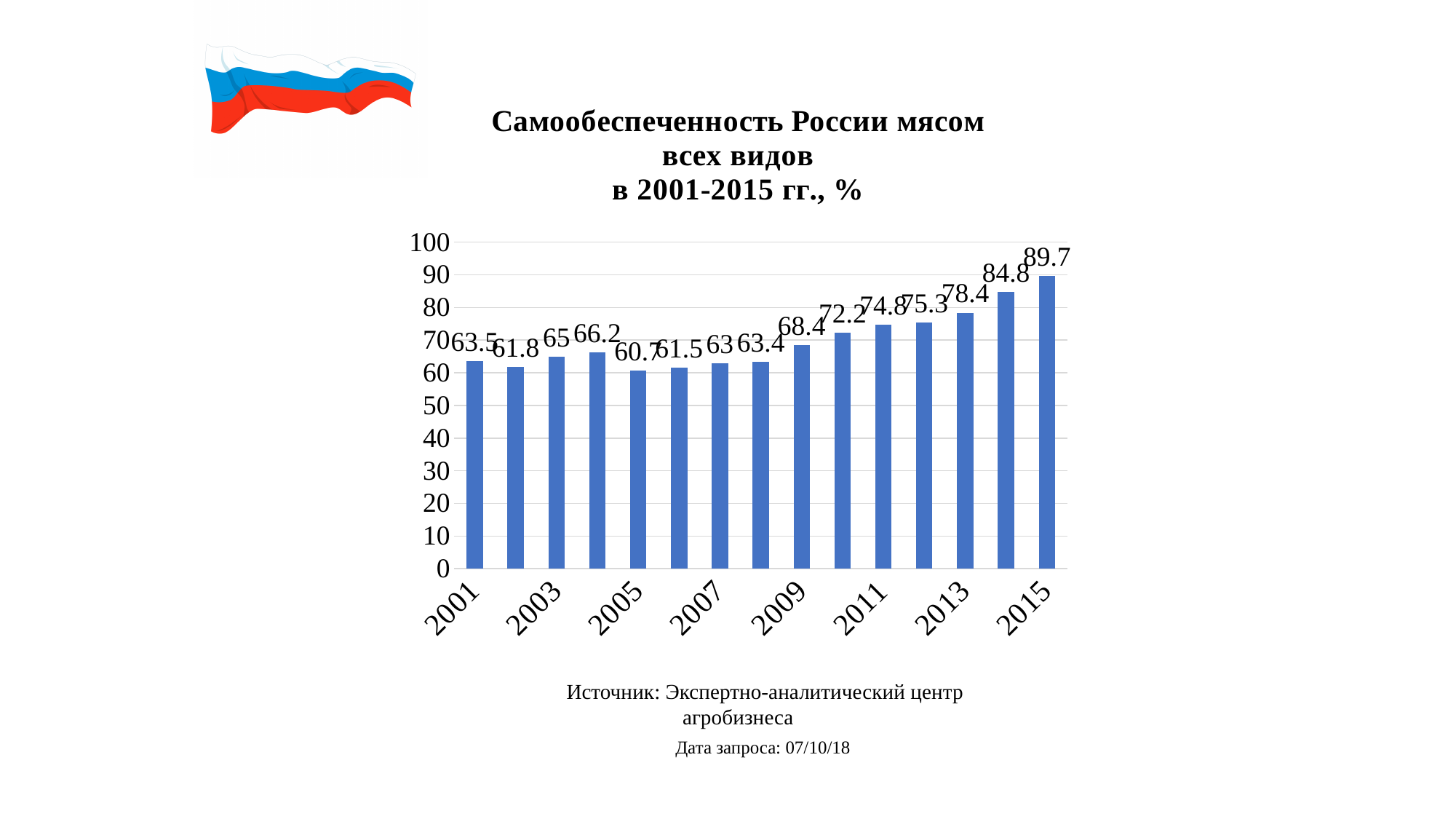
What is the value for 2013? 78.4 Is the value for 2003 greater or less than 70? less Which is larger, the value for 2011 or the value for 2007? 2011 What type of chart is shown on the slide? bar chart Which year has the highest value? 2015 Which year has the lowest value? 2005 How many bars are plotted in the chart? 15 What is the value for 2001? 63.5 What is the value for 2009? 68.4 What is the value for 2015? 89.7 Do the values generally rise or fall from 2009 to 2015? rise What is the difference between the values for 2015 and 2001? 26.2